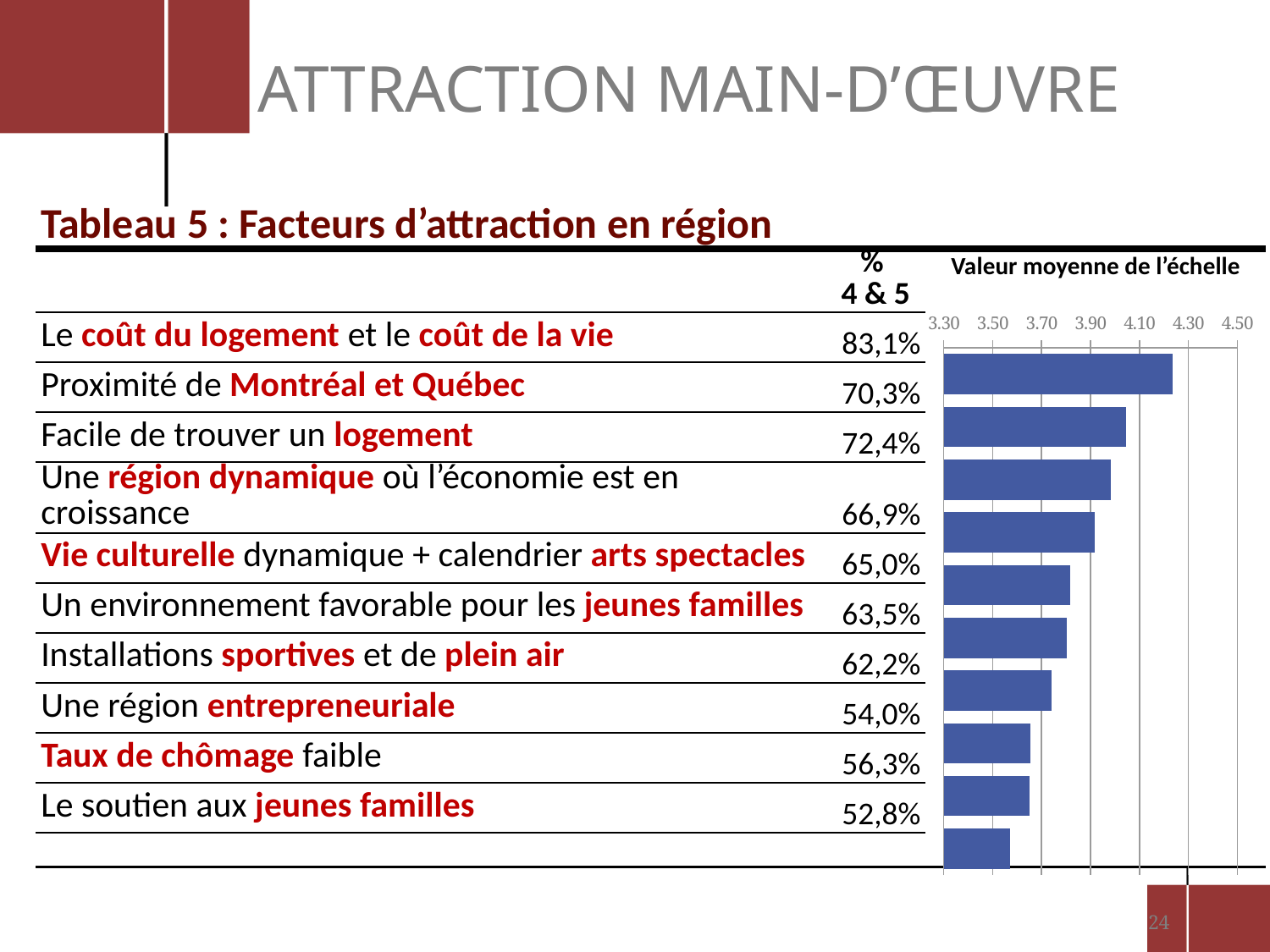
In the "Valeur moyenne de l'échelle" chart, is the value for "Le coût du logement et le coût de la vie" greater or less than 4.10? greater In the "Valeur moyenne de l'échelle" chart, is the value for "Une région entrepreneuriale" greater or less than 3.90? less What kind of chart is shown under "Valeur moyenne de l'échelle"? bar chart What is the highest tick value shown on the axis of the "Valeur moyenne de l'échelle" chart? 4.50 Which factor has the longest bar in the "Valeur moyenne de l'échelle" chart? Le coût du logement et le coût de la vie How many bars are plotted in the "Valeur moyenne de l'échelle" chart? 10 Which factor has the shortest bar in the "Valeur moyenne de l'échelle" chart? Le soutien aux jeunes familles What is the lowest tick value shown on the axis of the "Valeur moyenne de l'échelle" chart? 3.30 In the "Valeur moyenne de l'échelle" chart, is the value for "Le soutien aux jeunes familles" greater or less than 3.70? less In the "Valeur moyenne de l'échelle" chart, which bar is longer: "Facile de trouver un logement" or "Installations sportives et de plein air"? Facile de trouver un logement Do the bar lengths in the "Valeur moyenne de l'échelle" chart generally increase or decrease from the top row to the bottom row? decrease